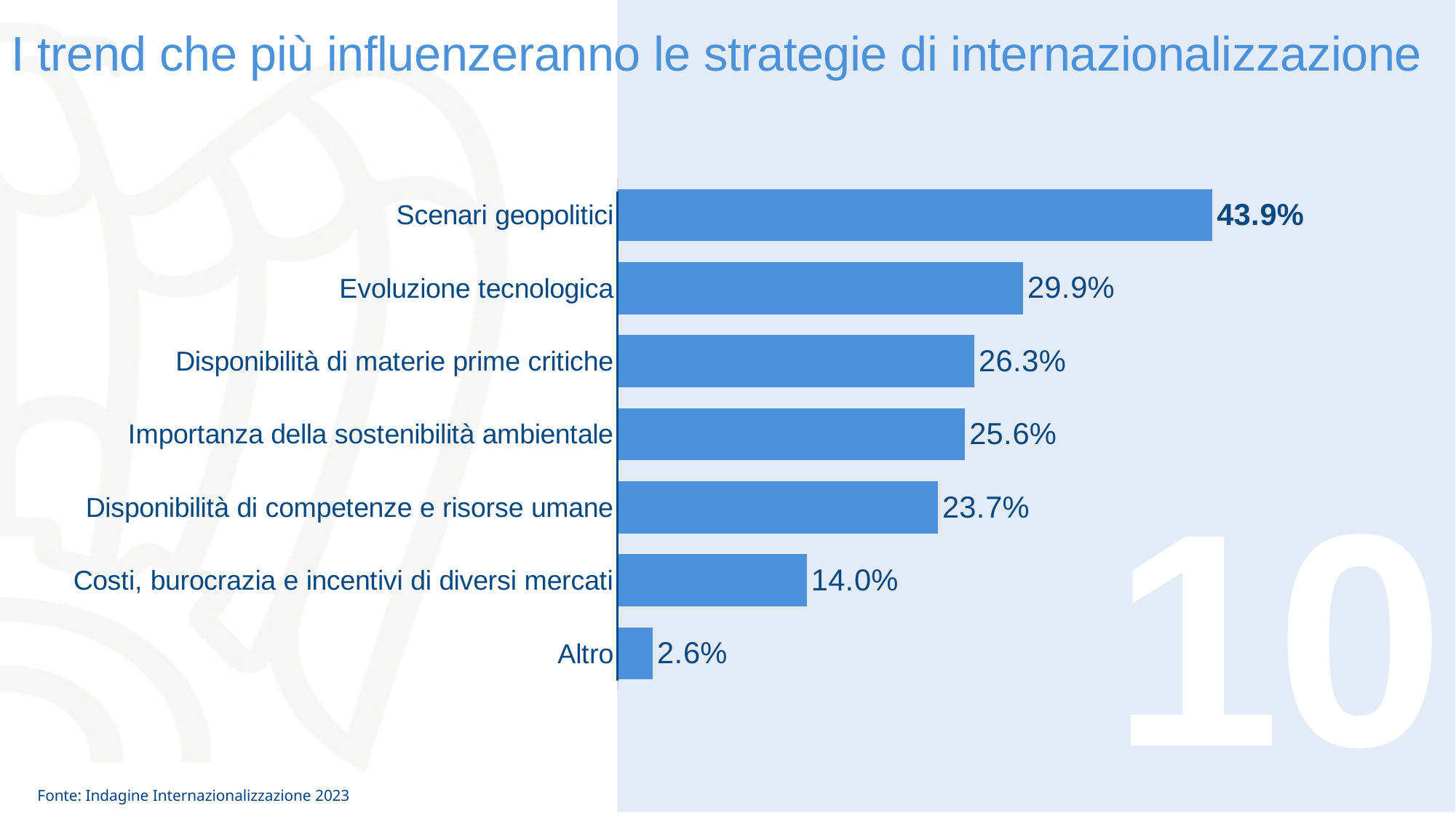
What is the value for Disponibilità di competenze e risorse umane? 23.7% What is the value for Costi, burocrazia e incentivi di diversi mercati? 14.0% What is the difference between Disponibilità di materie prime critiche and Importanza della sostenibilità ambientale? 0.7% What is the title of the slide? I trend che più influenzeranno le strategie di internazionalizzazione What is the value for Evoluzione tecnologica? 29.9% Which category has the highest value? Scenari geopolitici What is the value for Scenari geopolitici? 43.9% Which is larger: Evoluzione tecnologica or Disponibilità di materie prime critiche? Evoluzione tecnologica What is the difference between Scenari geopolitici and Evoluzione tecnologica? 14.0% Which category has the lowest value? Altro What kind of chart is shown on the slide? Bar chart How many categories are shown in the chart? 7